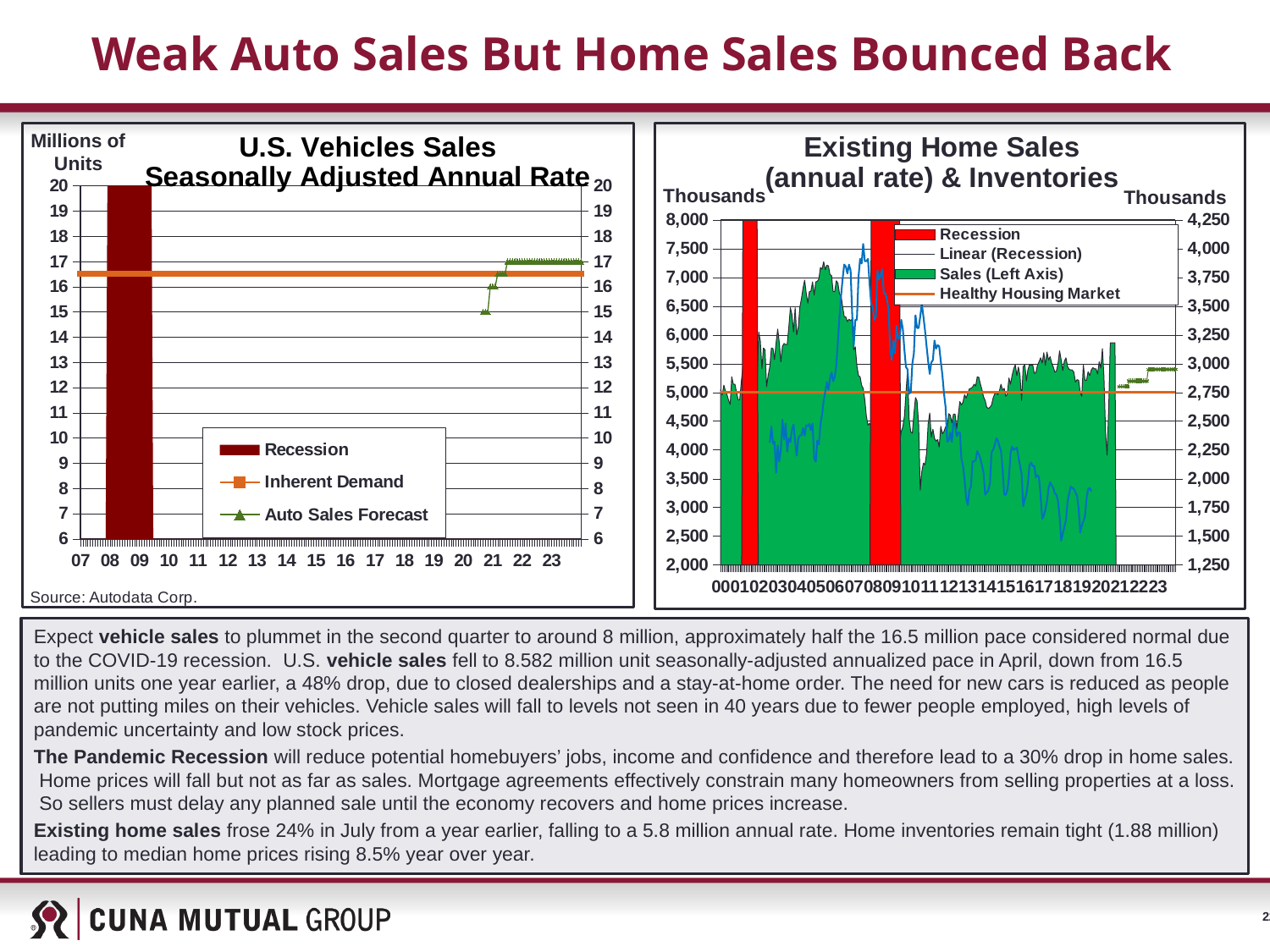
In the U.S. Vehicles Sales chart, is the Inherent Demand line greater or less than 17 million units? less How many series does the legend of the U.S. Vehicles Sales chart list? 3 In the Existing Home Sales chart, what is the highest value shown on the left axis? 8,000 In the U.S. Vehicles Sales chart, which series is shown as a dark red bar? Recession What source is cited for the U.S. Vehicles Sales chart? Autodata Corp. In the U.S. Vehicles Sales chart, does the Auto Sales Forecast rise or fall from 21 to 23? rise How many series does the legend of the Existing Home Sales chart list? 4 What kind of chart is the U.S. Vehicles Sales chart on the left? Line chart with a recession bar In the Existing Home Sales chart, is the Sales value around 2010 greater or less than 5,000 thousand? less In the U.S. Vehicles Sales chart, is the Inherent Demand line greater or less than 16 million units? greater